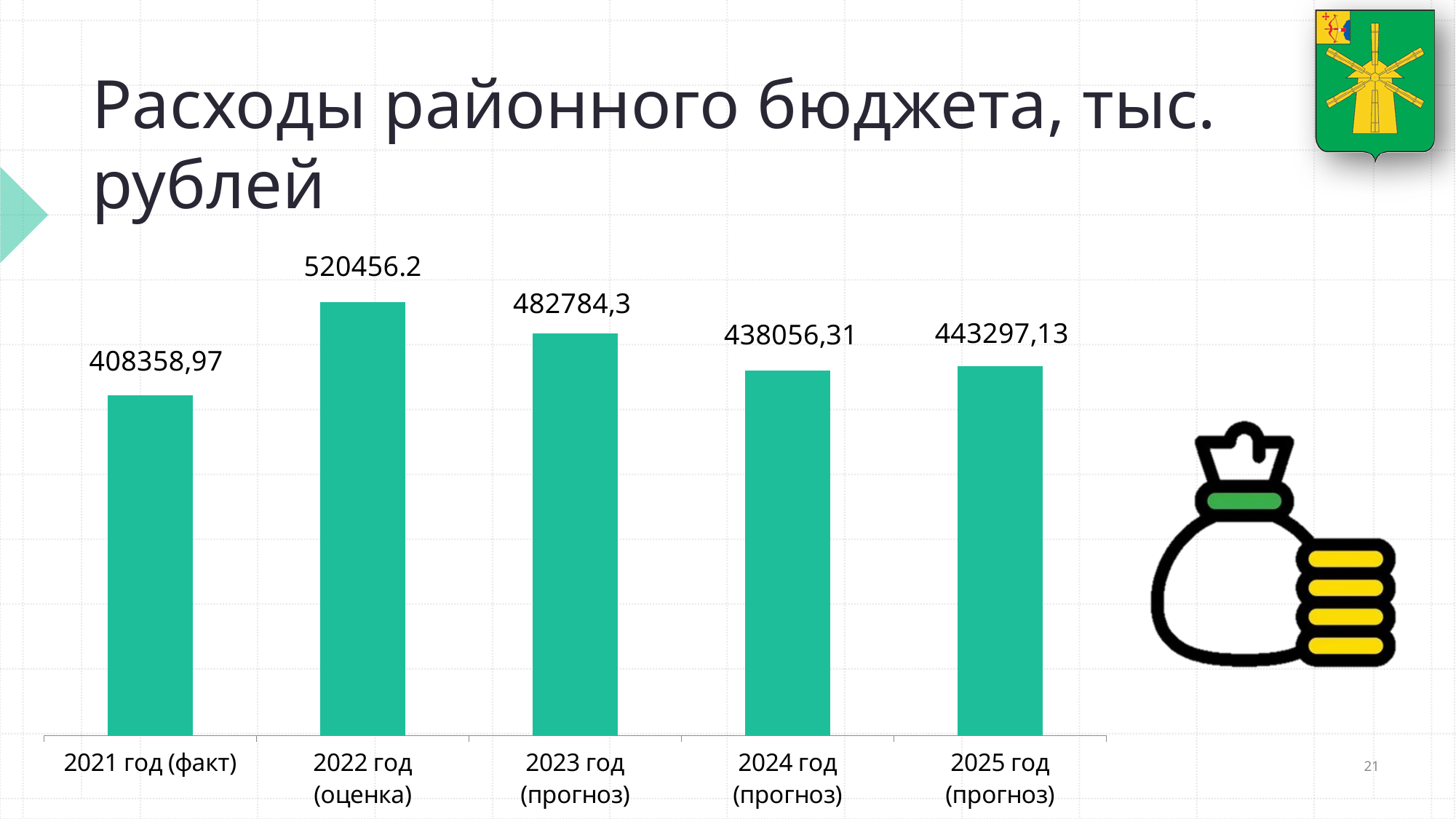
What is the value for 2025 год (прогноз)? 443297,13 Which year has the highest value? 2022 год (оценка) What is the difference between the values for 2023 год (прогноз) and 2024 год (прогноз)? 44727,99 How many bars are shown in the chart? 5 Which is larger, the value for 2024 год (прогноз) or 2025 год (прогноз)? 2025 год (прогноз) What is the value for 2024 год (прогноз)? 438056,31 What is the value for 2022 год (оценка)? 520456.2 What kind of chart is shown on the slide? bar chart What is the value for 2021 год (факт)? 408358,97 Which year has the lowest value? 2021 год (факт) What is the value for 2023 год (прогноз)? 482784,3 What is the title of the chart? Расходы районного бюджета, тыс. рублей